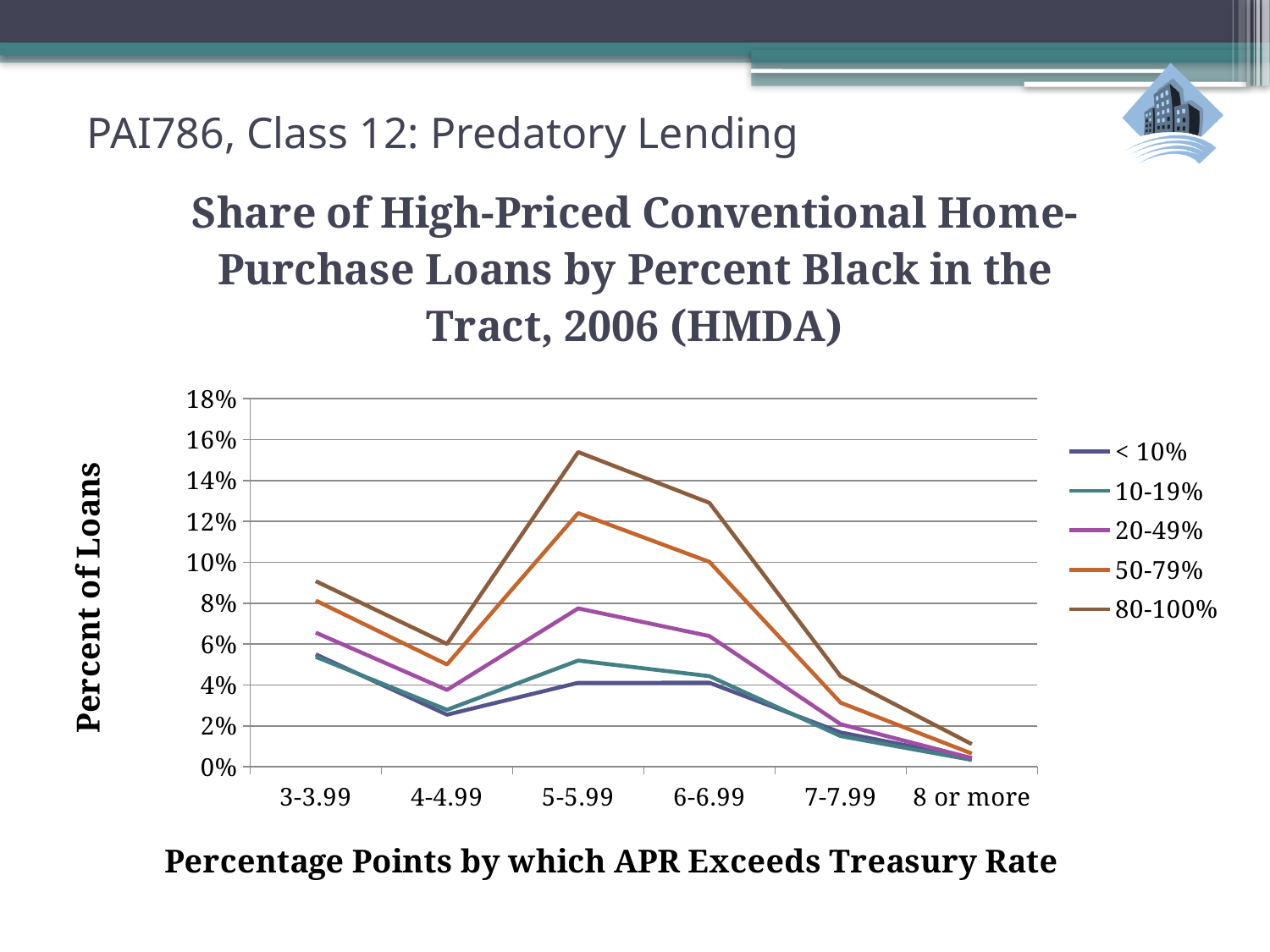
How many categories are shown along the x axis? 6 For the 80-100% series, which x-axis category has the highest value? 5-5.99 What is the title of the y axis? Percent of Loans Is the value for the 80-100% series at 5-5.99 greater or less than 14%? greater Is the value for the < 10% series at 4-4.99 greater or less than 4%? less At 3-3.99, which series has the larger value: 20-49% or 10-19%? 20-49% Do the values for the 80-100% series rise or fall from 6-6.99 to 8 or more? fall At 5-5.99, which series has the larger value: 80-100% or 50-79%? 80-100% Is the value for the 50-79% series at 5-5.99 greater or less than 10%? greater How many series does the legend list? 5 For the 80-100% series, which x-axis category has the lowest value? 8 or more What kind of chart is shown on the slide? line chart